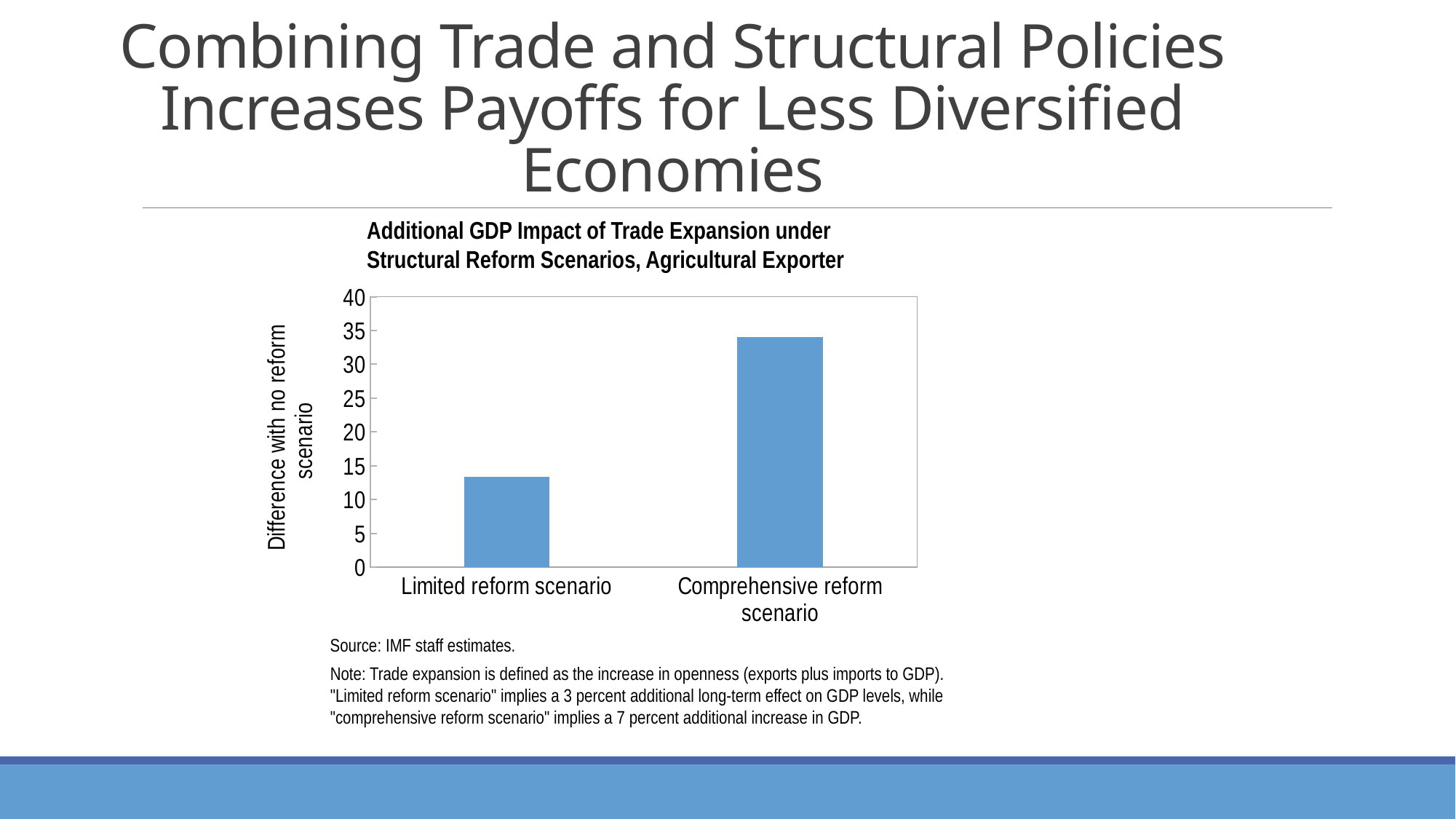
Is the value for the Limited reform scenario greater or less than 10? greater Is the value for the Limited reform scenario greater or less than 15? less What is the title of the chart? Additional GDP Impact of Trade Expansion under Structural Reform Scenarios, Agricultural Exporter How many categories are plotted in the chart? 2 Which scenario has the higher value in the chart? Comprehensive reform scenario Which scenario has the lower value in the chart? Limited reform scenario What is the label on the vertical axis of the chart? Difference with no reform scenario Is the value for the Comprehensive reform scenario larger or smaller than the value for the Limited reform scenario? larger What kind of chart is shown on the slide? bar chart Is the value for the Comprehensive reform scenario greater or less than 30? greater What is the highest value shown on the vertical axis of the chart? 40